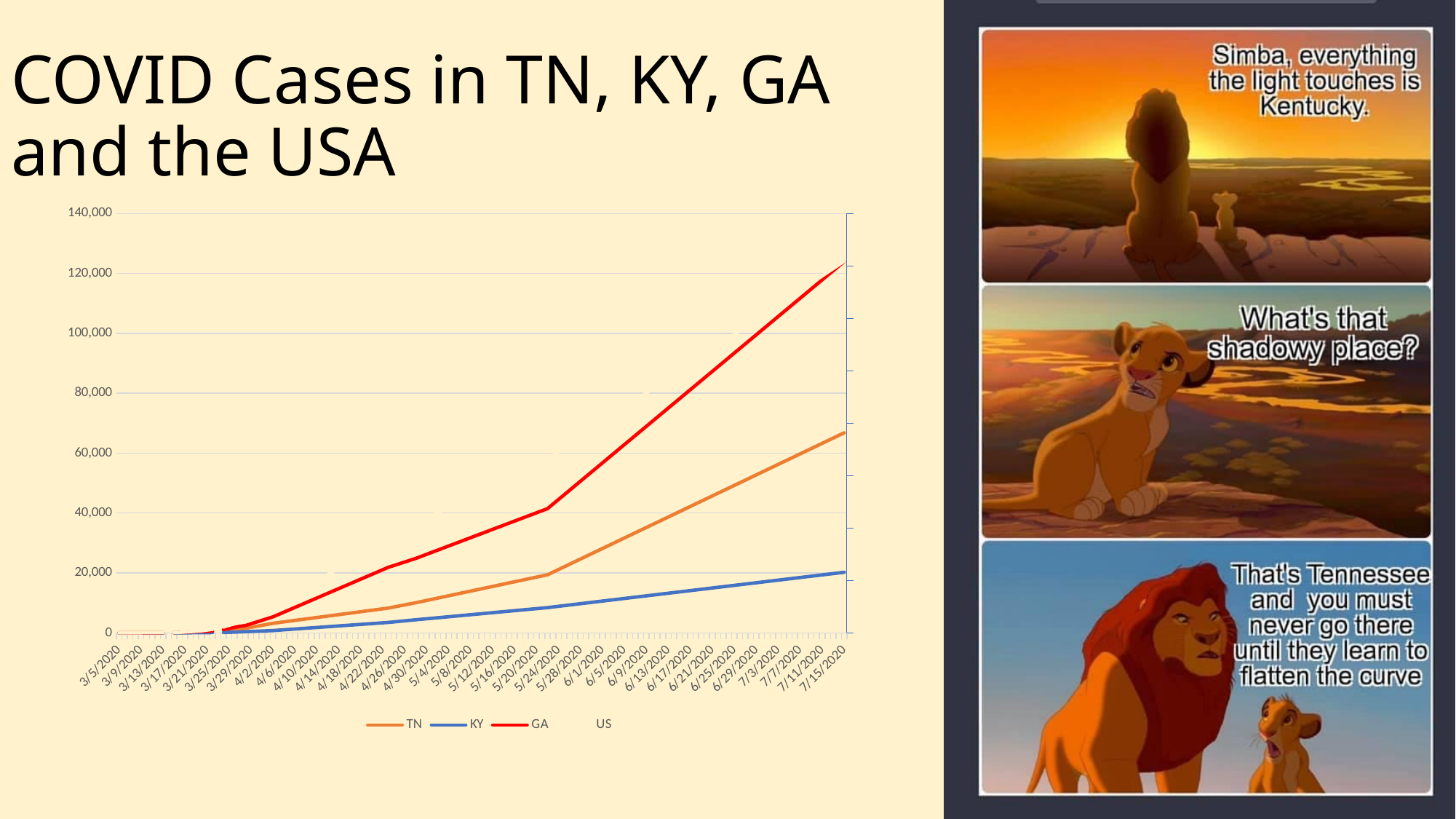
Is the value for GA on 7/15/2020 greater or less than 100,000? greater What is the title of the slide containing the chart? COVID Cases in TN, KY, GA and the USA Which of the plotted state lines has the lowest value on 7/15/2020? KY Is the value for TN on 7/15/2020 greater or less than 60,000? greater What colour is the GA line in the chart? red Is the value for KY on 7/15/2020 greater or less than 40,000? less How many series does the chart legend list? 4 Do the plotted lines rise or fall from 3/5/2020 to 7/15/2020? rise Which is larger on 6/1/2020, the value for TN or the value for KY? TN What kind of chart is shown on the slide? line chart